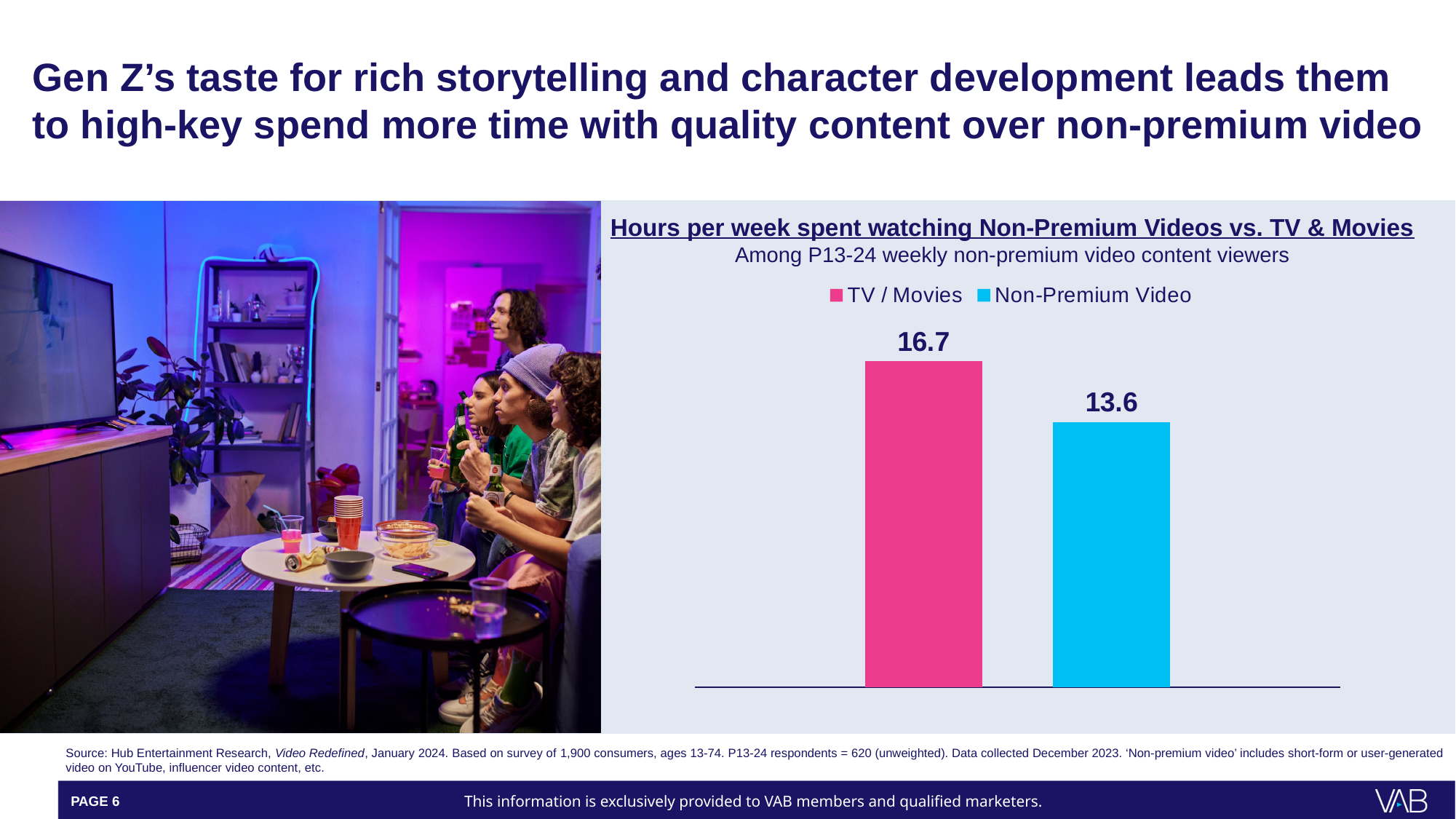
How many series does the legend list? 2 How many hours per week do P13-24 viewers spend watching Non-Premium Video? 13.6 How many hours per week do P13-24 viewers spend watching TV / Movies? 16.7 Is the value for Non-Premium Video larger or smaller than the value for TV / Movies? smaller What is the difference in hours per week between TV / Movies and Non-Premium Video? 3.1 What kind of chart is shown on the slide? bar chart Which series has the lower value in the chart? Non-Premium Video Which series has the higher value, TV / Movies or Non-Premium Video? TV / Movies What colour is the Non-Premium Video bar? blue What is the title of the chart? Hours per week spent watching Non-Premium Videos vs. TV & Movies How many bars are plotted in the chart? 2